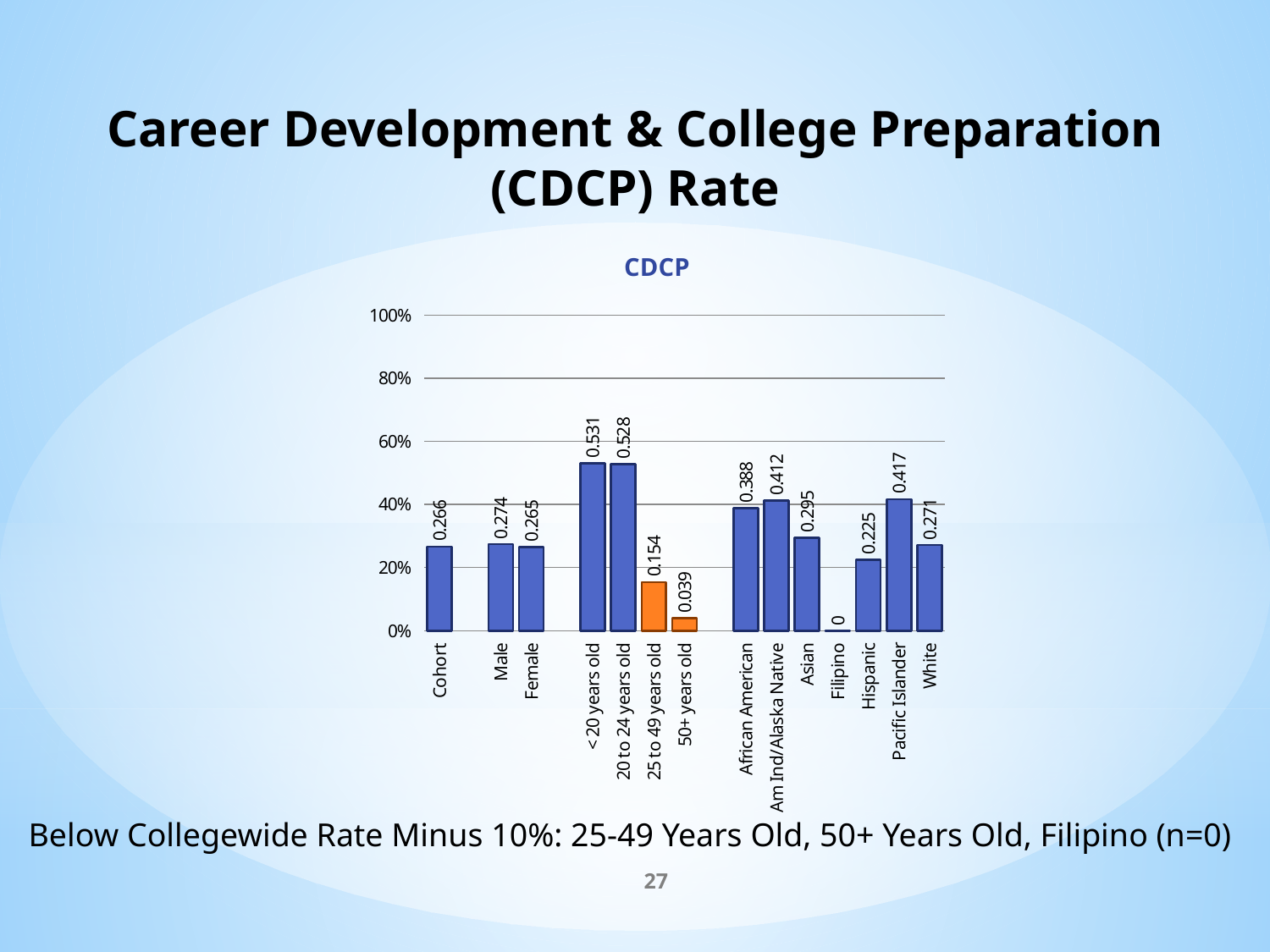
How many categories are plotted in the CDCP chart? 14 Which category has the lowest value in the CDCP chart? Filipino Which category has the highest value in the CDCP chart? < 20 years old Which categories are shown with orange bars instead of blue? 25 to 49 years old and 50+ years old What is the difference between the values for African American and Hispanic? 0.163 What is the CDCP value for the Cohort category? 0.266 What is the value shown for Am Ind/Alaska Native? 0.412 What is the value shown for 50+ years old? 0.039 What is the value shown for Pacific Islander? 0.417 Which has a larger value, Asian or White? Asian What type of chart is shown on the slide? Bar chart What is the difference between the values for < 20 years old and 50+ years old? 0.492